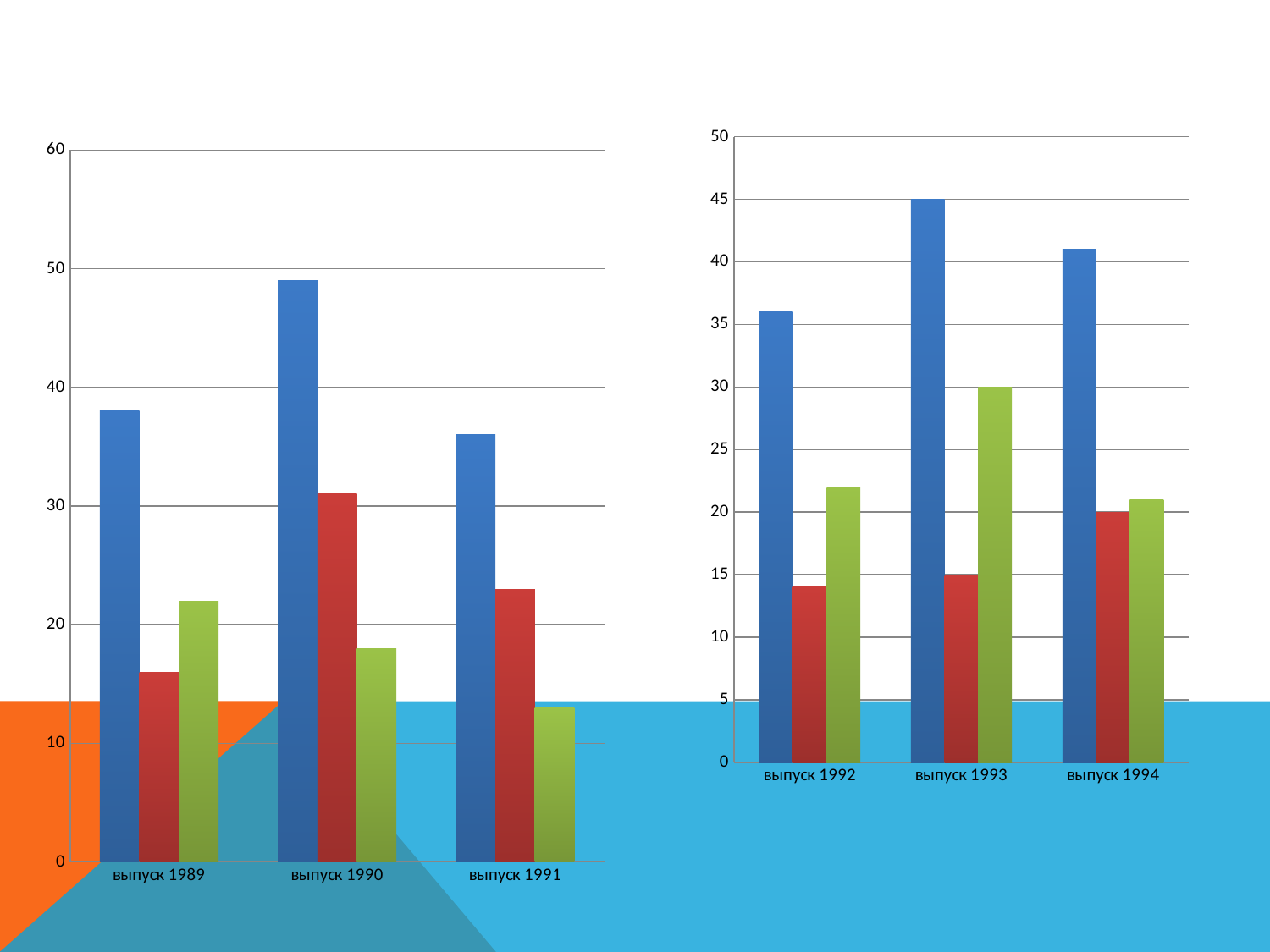
In the right chart, which category has the tallest blue bar? выпуск 1993 In the left chart, is the red bar for выпуск 1989 greater or less than 20? less In the left chart, is the blue bar for выпуск 1990 greater or less than 40? greater In the right chart, is the green bar for выпуск 1993 greater or less than 25? greater In the right chart, which category has the shortest red bar? выпуск 1992 In the left chart, which is taller: the green bar for выпуск 1989 or the green bar for выпуск 1991? выпуск 1989 How many categories are shown on the x axis of the right chart? 3 What kind of chart is the chart on the left side of the slide? bar chart In the left chart, which category has the tallest blue bar? выпуск 1990 In the right chart, which is taller: the blue bar for выпуск 1992 or the blue bar for выпуск 1994? выпуск 1994 How many categories are shown on the x axis of the left chart? 3